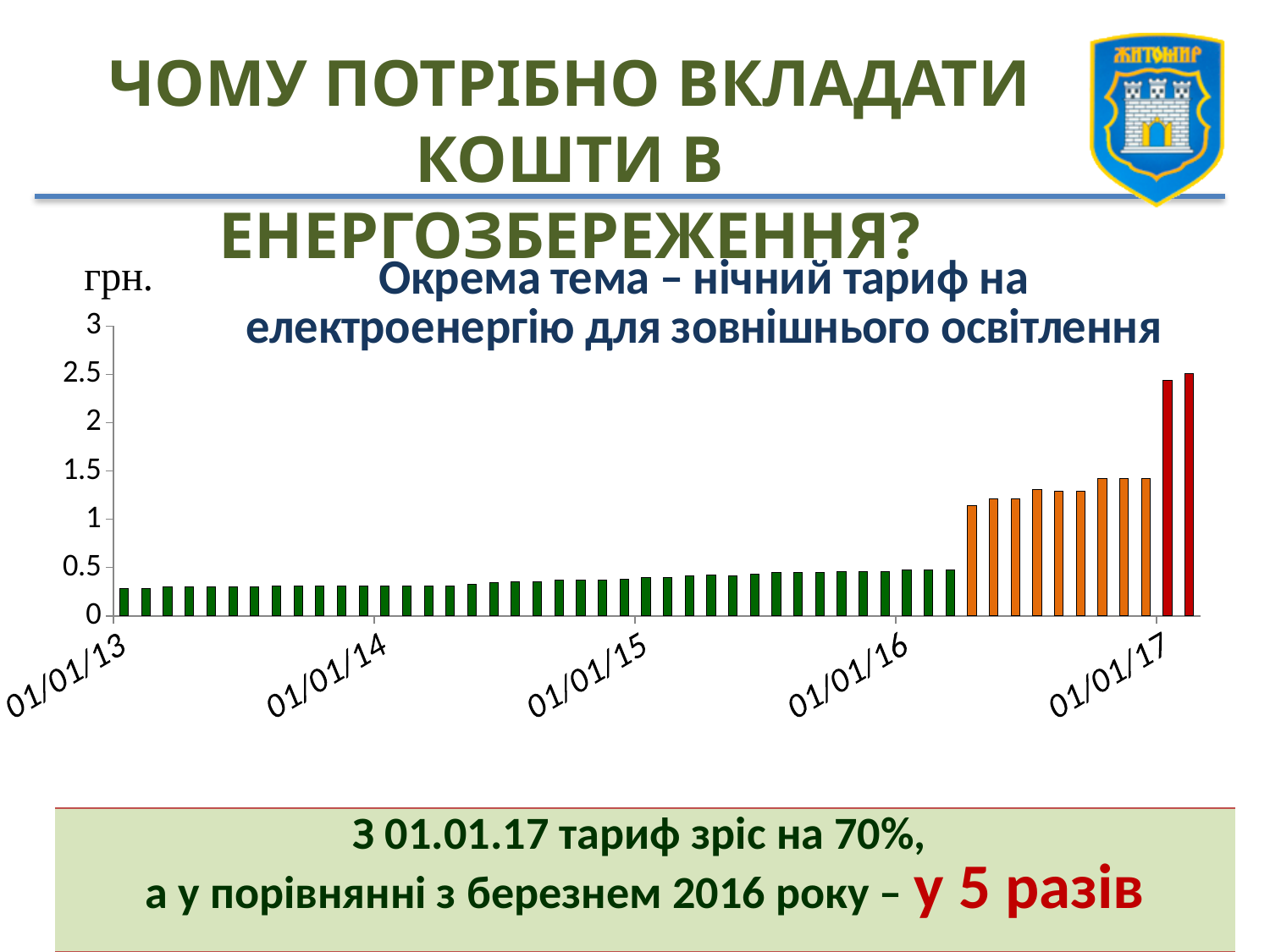
Is the value for 01/01/17 greater or less than 2? greater How many date labels are shown on the horizontal axis? 5 What is the highest value shown on the vertical axis? 3 Is the value for 01/01/15 greater or less than 0.5? less What is the title of the chart? Окрема тема – нічний тариф на електроенергію для зовнішнього освітлення Is the value for 01/01/13 greater or less than 0.5? less Which is larger, the value for 01/01/13 or the value for 01/01/16? 01/01/16 Do the values generally rise or fall from 01/01/13 to 01/01/17? rise What unit is shown at the top of the vertical axis? грн. What kind of chart is shown on the slide? bar chart Which is larger, the value for 01/01/16 or the value for 01/01/17? 01/01/17